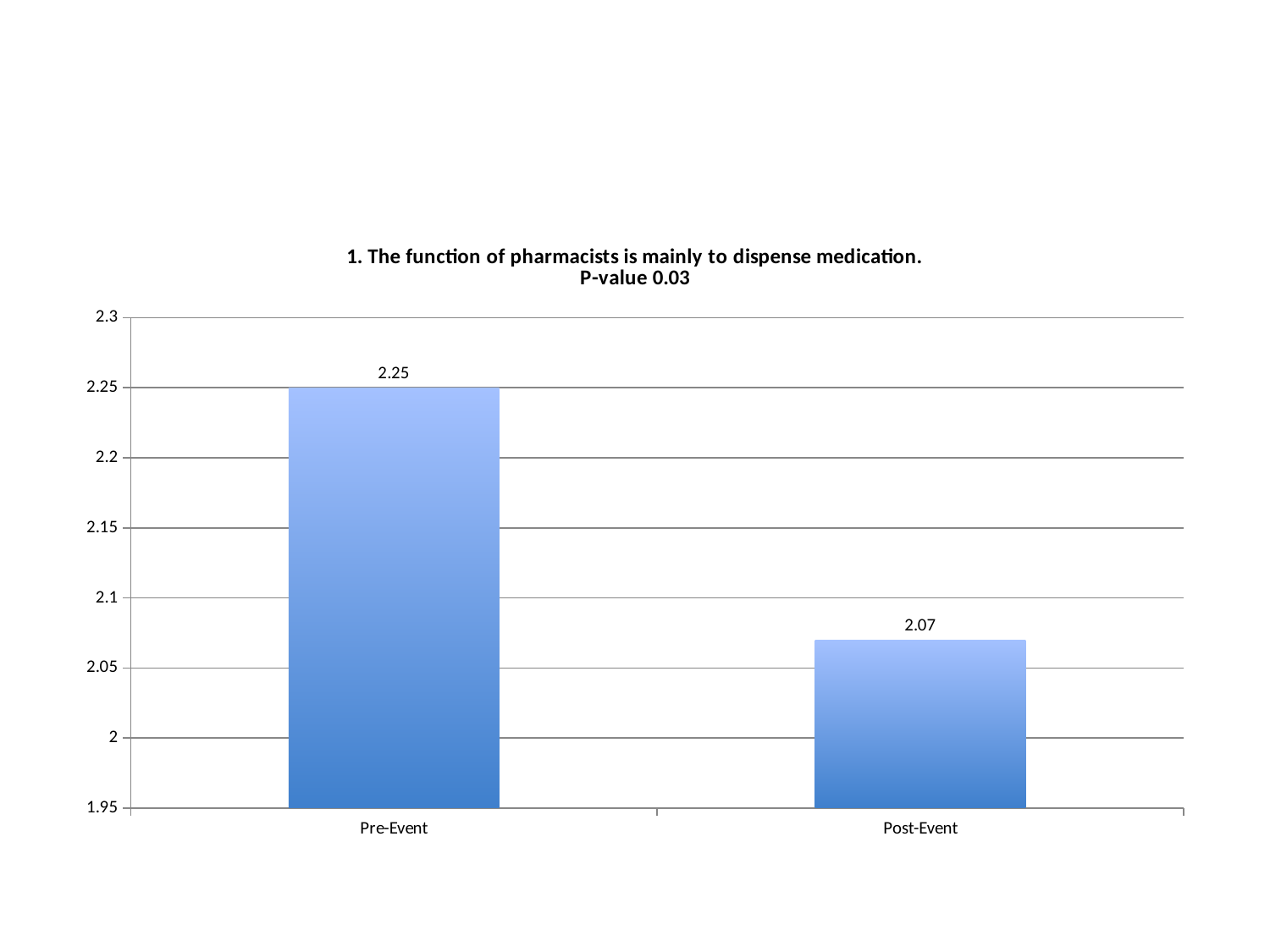
What is the value for Post-Event? 2.07 Which category has the lowest value? Post-Event Is the value for Post-Event greater or less than 2.1? less What is the difference between the Pre-Event and Post-Event values? 0.18 What kind of chart is shown on the slide? bar chart What P-value is stated in the chart title? 0.03 Which is larger, the value for Pre-Event or the value for Post-Event? Pre-Event Do the values rise or fall from Pre-Event to Post-Event? fall What is the value for Pre-Event? 2.25 How many categories are shown on the x axis? 2 Is the value for Pre-Event greater or less than 2.2? greater Which category has the highest value? Pre-Event